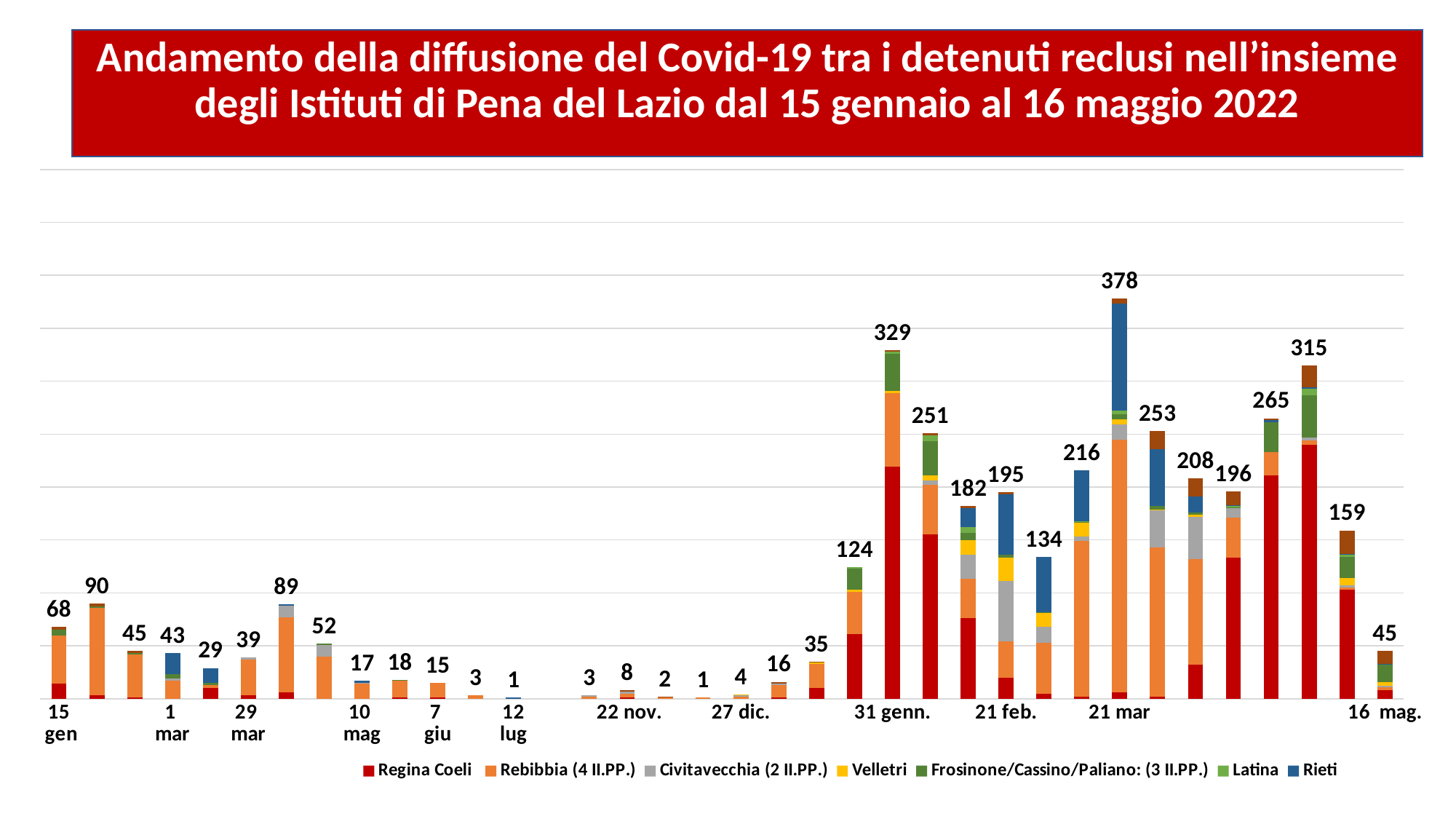
What is the difference between the totals for 21 mar and 31 genn.? 49 What is the difference between the totals for 21 feb. and 16 mag.? 150 Which series is listed first in the legend? Regina Coeli What is the total number of cases shown for 16 mag.? 45 Which date has the highest total on the chart? 21 mar What is the total number of cases shown for 31 genn.? 329 Which has a larger total, 31 genn. or 21 feb.? 31 genn. What kind of chart is shown on the slide? stacked bar chart What is the total number of cases shown for 21 mar? 378 What is the total number of cases shown for 12 lug? 1 What is the total number of cases shown for 15 gen? 68 How many series does the legend list? 7